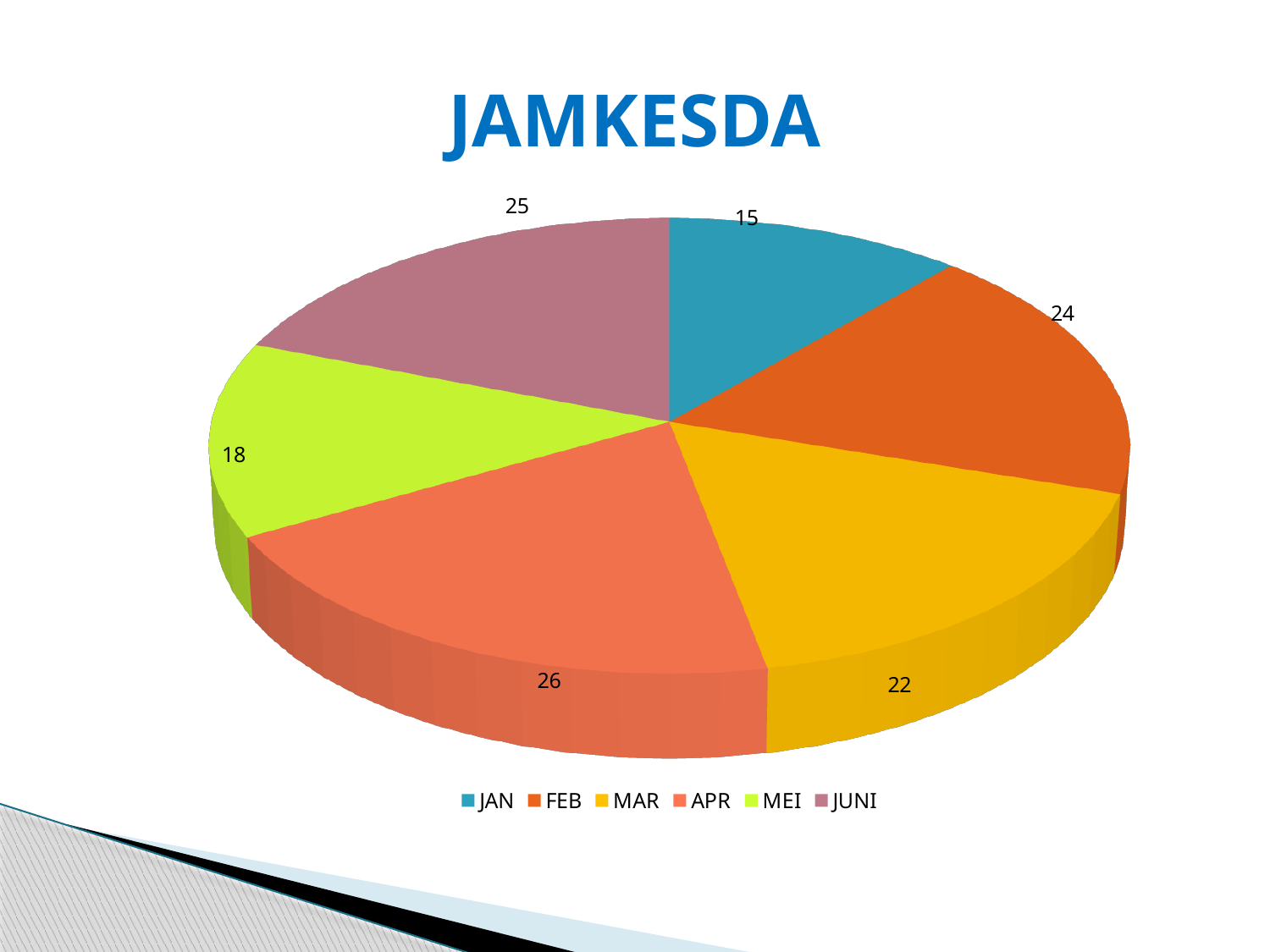
What is the value for MEI? 18 What is the difference between the values for JUNI and JAN? 10 How many slices does the pie chart have? 6 What is the difference between the values for FEB and MAR? 2 What type of chart is shown on the slide? pie chart Which month has the largest slice? APR What is the value for APR? 26 Which month has the smallest slice? JAN What is the value for JAN? 15 What is the total of all the slice values? 130 What is the title of the chart? JAMKESDA Which is larger, the value for MAR or the value for MEI? MAR